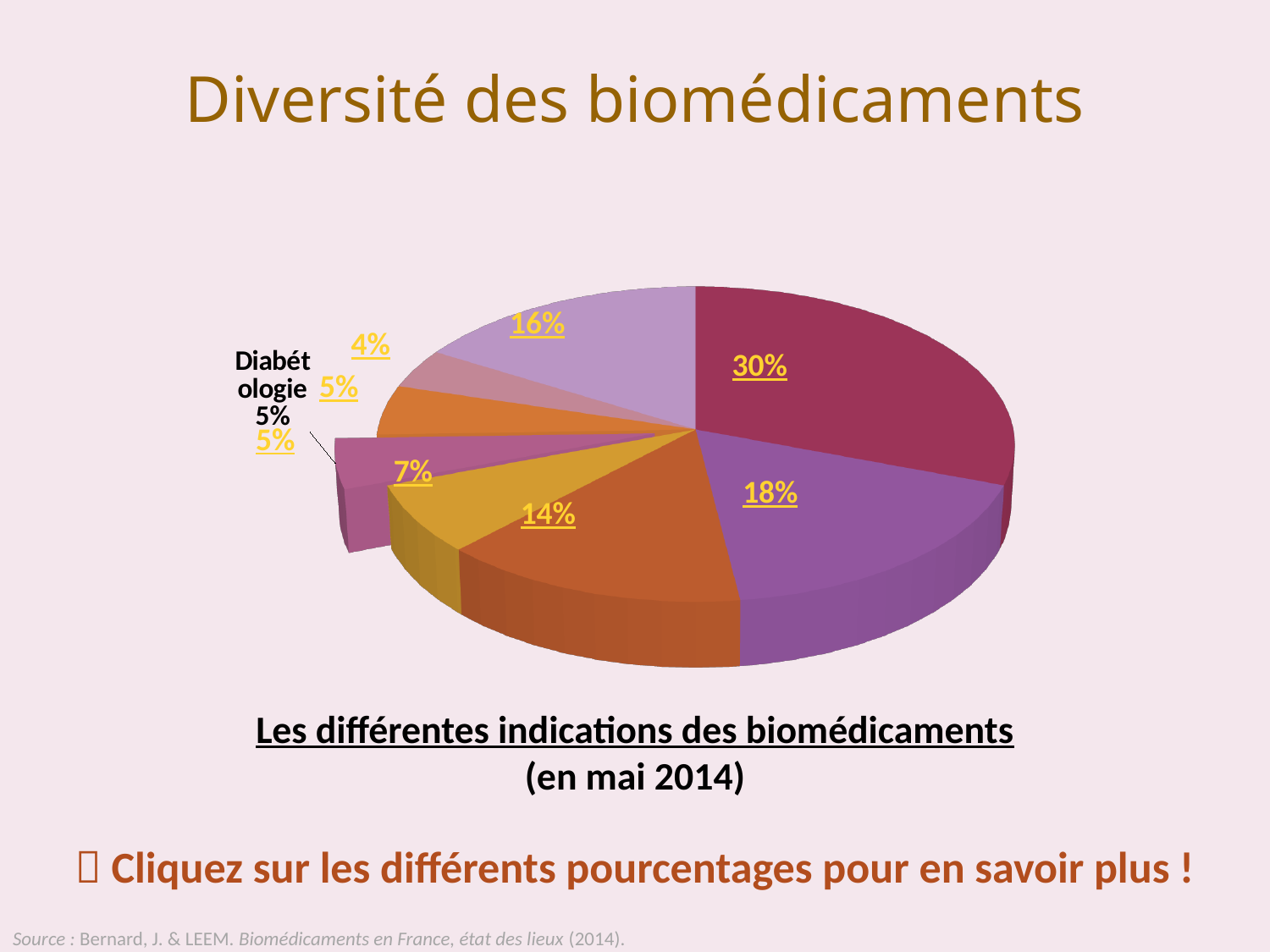
What share of the pie does Diabétologie represent? 5% Is the slice labelled 7% larger or smaller than the slice labelled 14%? smaller How many slices does the pie chart have? 8 What is the title written below the pie chart? Les différentes indications des biomédicaments (en mai 2014) Which is larger: the slice labelled 16% or the slice labelled 14%? 16% What is the percentage of the largest slice in the pie chart? 30% How many slices in the pie chart are labelled 5%? 2 What kind of chart is shown on the slide? pie chart What is the percentage of the smallest slice in the pie chart? 4% Which slice is pulled out from the rest of the pie? Diabétologie 5% What is the difference in percentage points between the largest slice (30%) and the second largest slice (18%)? 12 What is the difference in percentage points between the largest slice and the smallest slice? 26